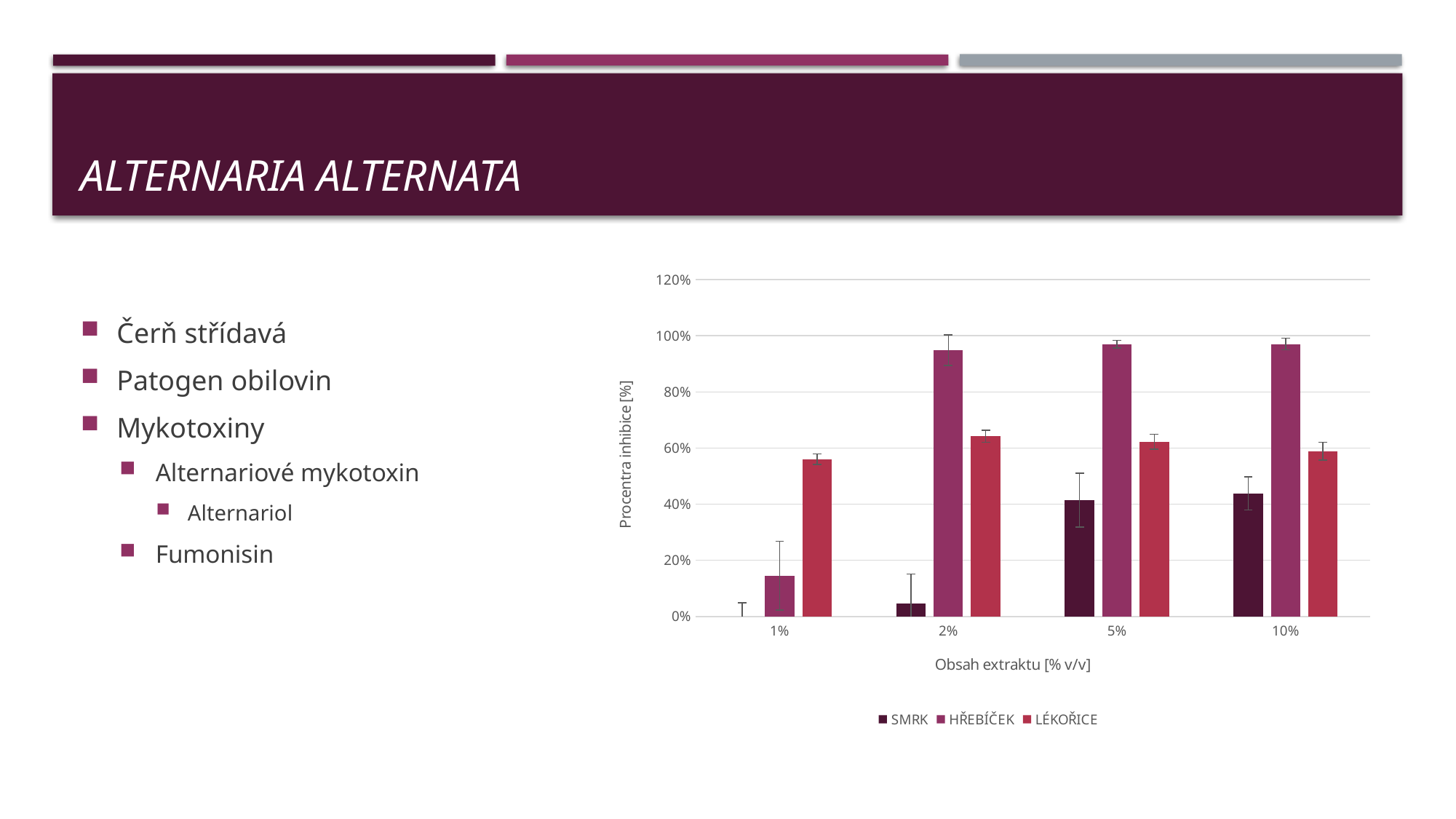
What is the label of the y axis? Procentra inhibice [%] Is the value for HŘEBÍČEK at 2% greater or less than 80%? greater Which series has the highest value at 10%? HŘEBÍČEK Which series has the lowest value at 2%? SMRK At 1%, which series has the larger value, HŘEBÍČEK or LÉKOŘICE? LÉKOŘICE Is the value for SMRK at 5% greater or less than 20%? greater Is the value for LÉKOŘICE at 1% greater or less than 60%? less How many extract concentration categories are shown on the x axis? 4 At 5%, which series has the larger value, SMRK or HŘEBÍČEK? HŘEBÍČEK How many series does the legend list? 3 What kind of chart is shown on the slide? bar chart